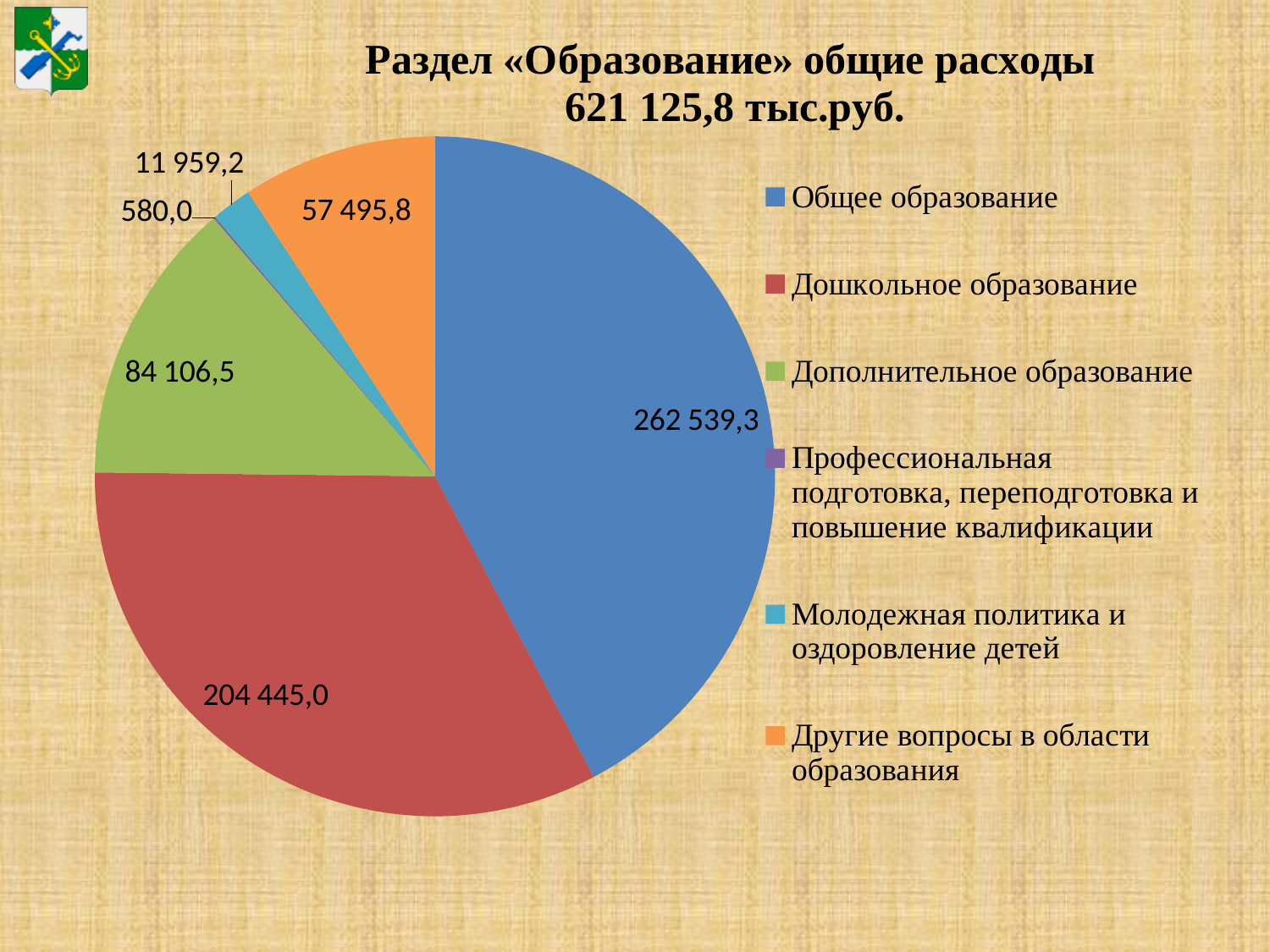
Which category has the smallest slice of the pie? Профессиональная подготовка, переподготовка и повышение квалификации How many categories does the pie chart have? 6 What is the value for Молодежная политика и оздоровление детей? 11 959,2 What is the difference between the values for Общее образование and Дошкольное образование? 58 094,3 What is the value for Профессиональная подготовка, переподготовка и повышение квалификации? 580,0 What is the value for Дополнительное образование? 84 106,5 What is the value for Дошкольное образование? 204 445,0 What kind of chart is shown on the slide? pie chart What total expenditure is stated in the chart title? 621 125,8 тыс.руб. Which category has the largest slice of the pie? Общее образование What is the value for Общее образование? 262 539,3 Which is larger, the value for Дополнительное образование or the value for Другие вопросы в области образования? Дополнительное образование